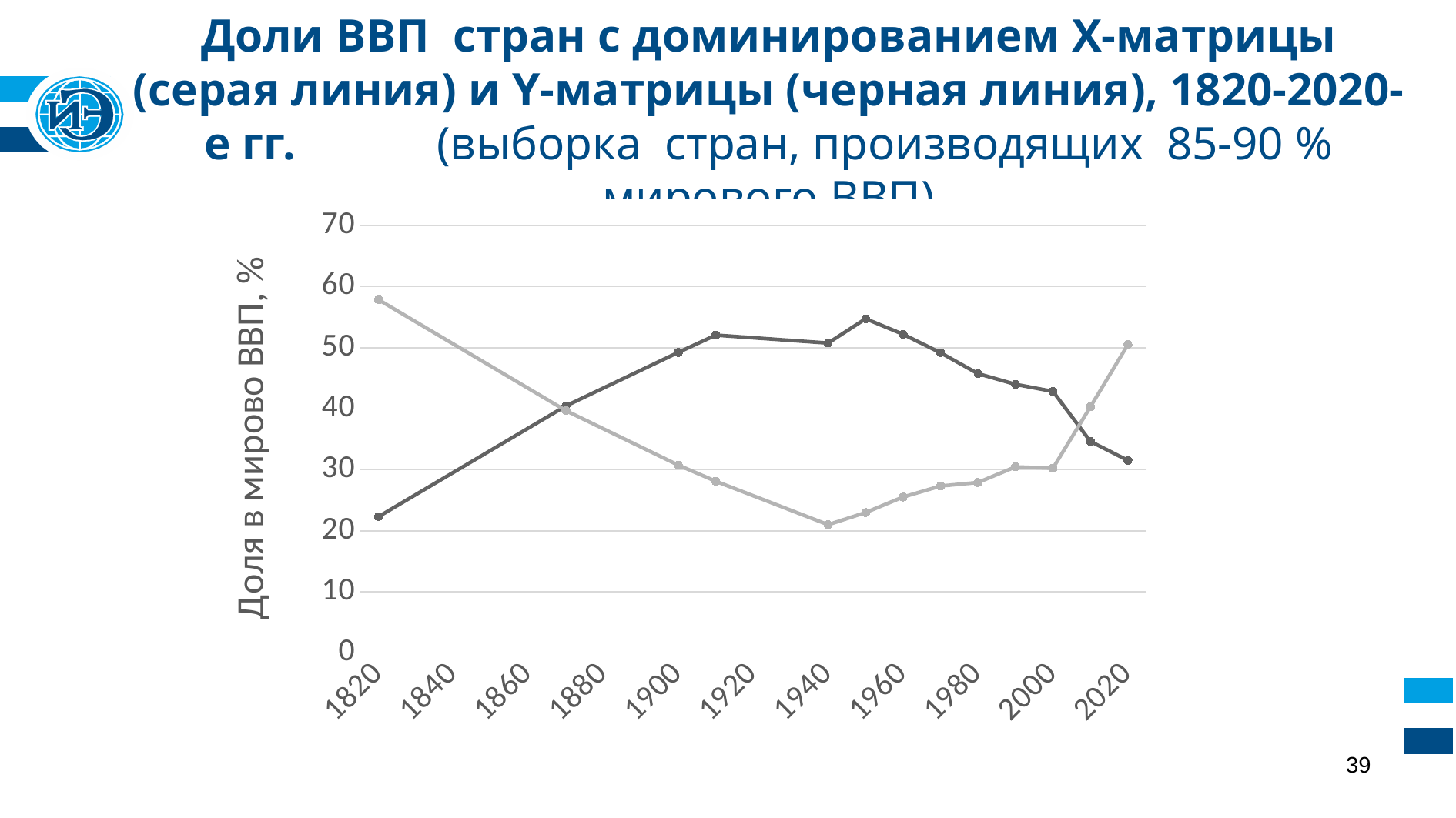
In which year does the grey line (X-матрица) reach its highest value? 1820 Is the value of the black line (Y-матрица) in 1820 greater or less than 30? less Which line has the higher value in 1960, the grey line or the black line? The black line Does the grey line (X-матрица) rise or fall between 1820 and 1940? Fall Is the value of the grey line (X-матрица) in 1820 greater or less than 50? greater Is the value of the black line (Y-матрица) in 2020 greater or less than 40? less What is the label of the vertical axis? Доля в мирово ВВП, % What kind of chart is shown on the slide? Line chart In which year does the black line (Y-матрица) reach its lowest value? 1820 In which year does the grey line (X-матрица) reach its lowest value? 1940 How many lines are plotted on the chart? 2